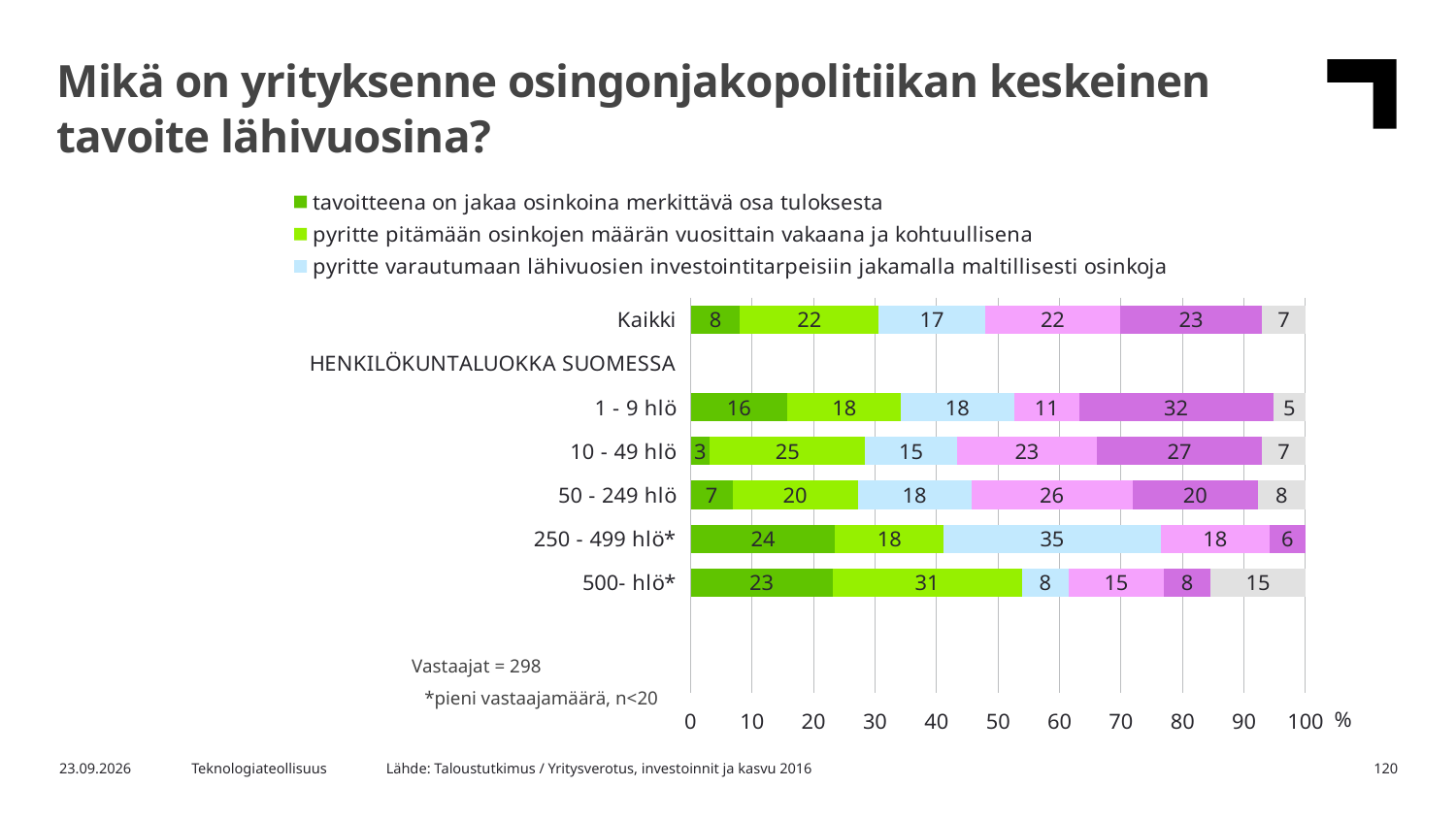
What is the value for 'pyritte pitämään osinkojen määrän vuosittain vakaana ja kohtuullisena' in the 10 - 49 hlö bar? 25 What type of chart is shown on the slide? Stacked bar chart How many category bars are plotted in the chart? 6 Which has the larger value for 'pyritte varautumaan lähivuosien investointitarpeisiin jakamalla maltillisesti osinkoja': 1 - 9 hlö or 10 - 49 hlö? 1 - 9 hlö Which category has the lowest value for 'tavoitteena on jakaa osinkoina merkittävä osa tuloksesta'? 10 - 49 hlö How many series does the legend list? 3 What is the title of the slide containing the chart? Mikä on yrityksenne osingonjakopolitiikan keskeinen tavoite lähivuosina? What is the value of the first (dark green) segment in the 500- hlö* bar? 23 What is the difference between the 'pyritte pitämään osinkojen määrän vuosittain vakaana ja kohtuullisena' values for 500- hlö* and Kaikki? 9 Which category has the highest value for 'pyritte pitämään osinkojen määrän vuosittain vakaana ja kohtuullisena'? 500- hlö* What is the value for 'tavoitteena on jakaa osinkoina merkittävä osa tuloksesta' in the Kaikki bar? 8 What is the value for 'pyritte varautumaan lähivuosien investointitarpeisiin jakamalla maltillisesti osinkoja' in the 250 - 499 hlö* bar? 35